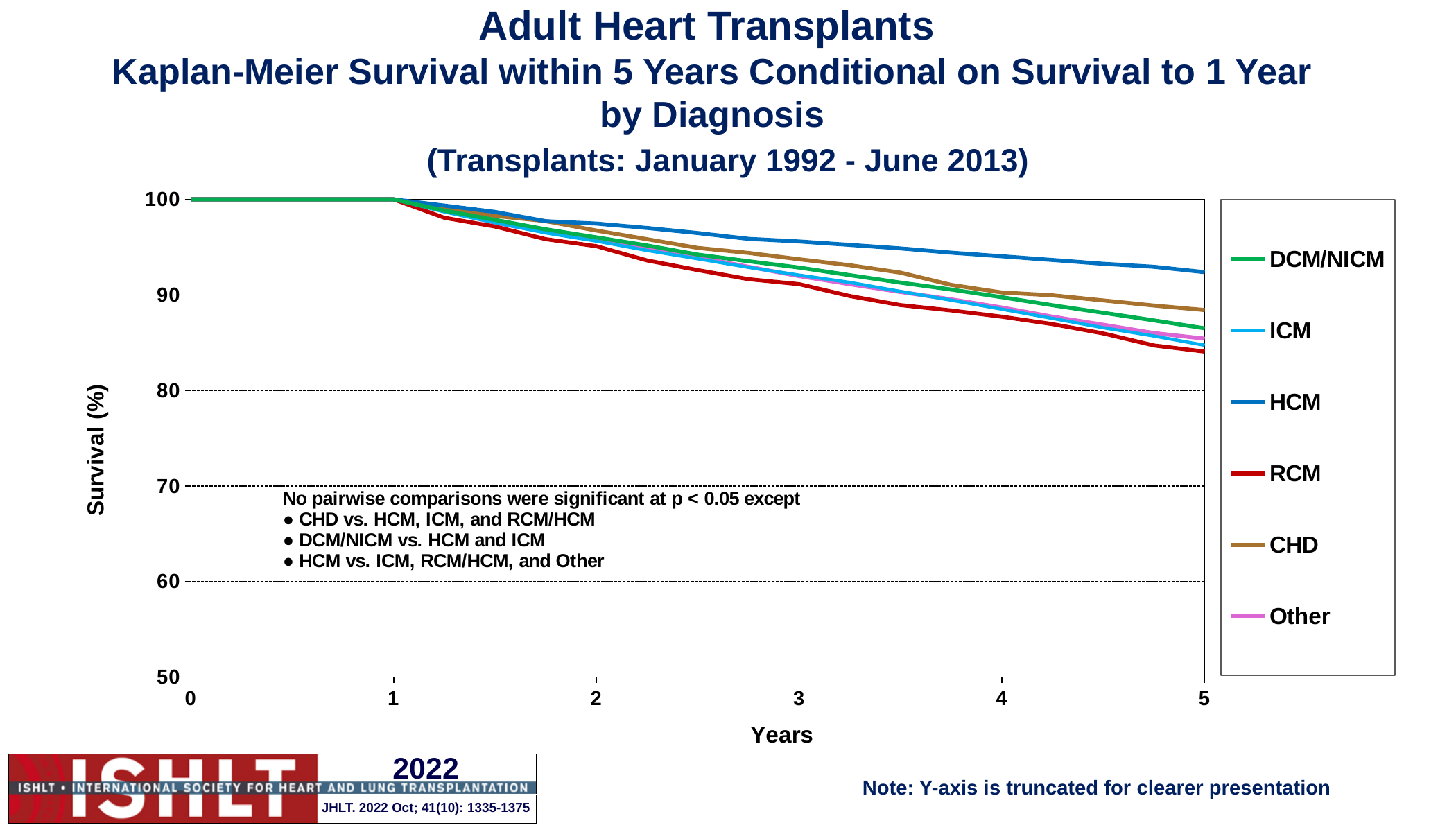
Which diagnosis group has the lowest survival at 5 years? RCM Is the survival value for DCM/NICM at 5 years greater or less than 90? less What kind of chart is shown on the slide? line chart Do the survival curves rise or fall as years increase from 1 to 5? fall Is the survival value for HCM at 5 years greater or less than 90? greater What colour is the HCM line in the legend? blue What is the label of the y-axis? Survival (%) At 3 years, which has higher survival, HCM or RCM? HCM How many series does the legend list? 6 Which diagnosis group has the highest survival at 5 years? HCM What is the survival value for HCM at 1 year? 100 Is the survival value for RCM at 5 years greater or less than 90? less